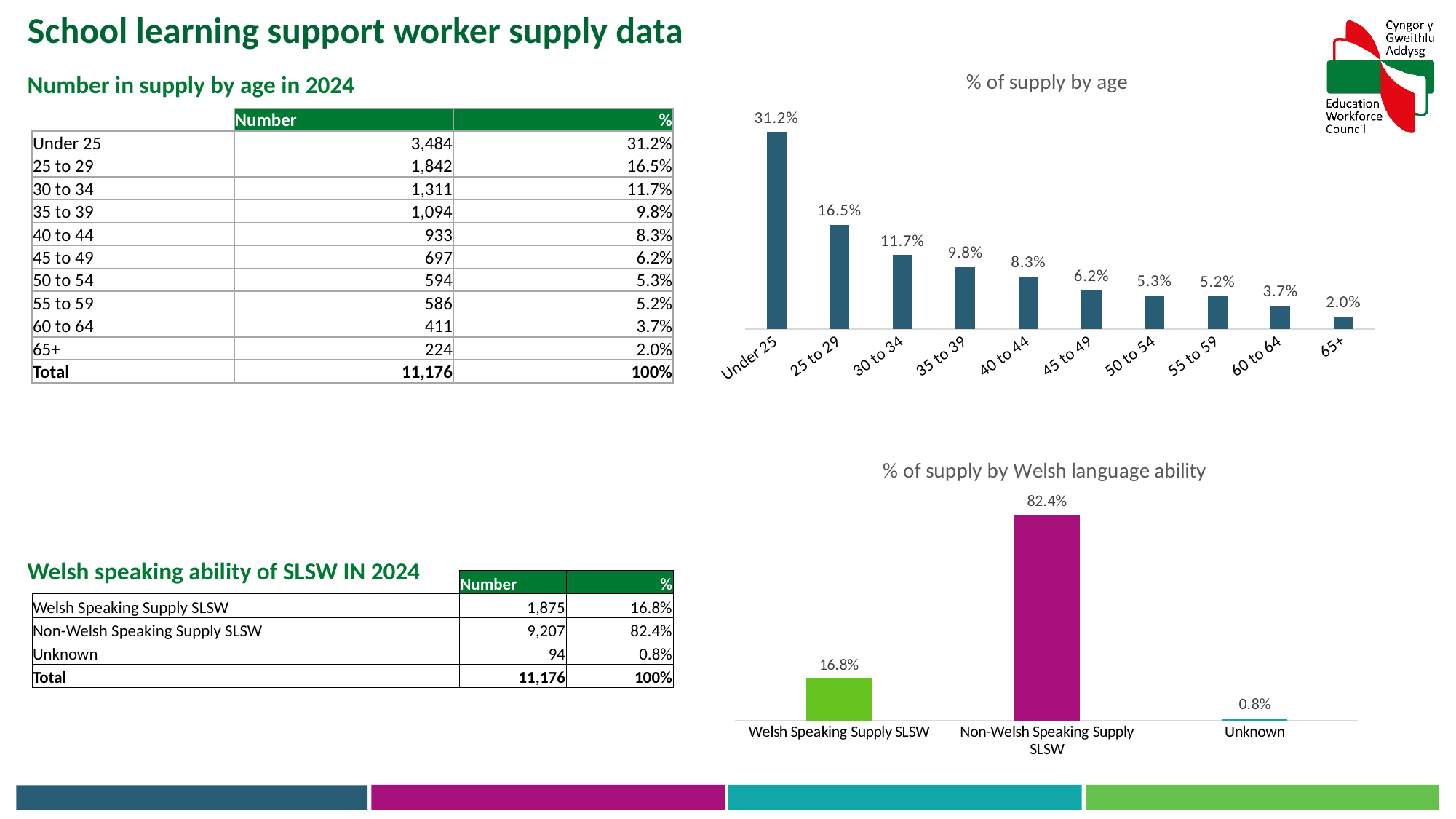
In the '% of supply by age' chart, what is the value for 30 to 34? 11.7% In the '% of supply by age' chart, which is larger, the value for 40 to 44 or the value for 45 to 49? 40 to 44 Do the values in the '% of supply by age' chart rise or fall from left to right along the x axis? fall In the '% of supply by age' chart, which age group has the highest value? Under 25 In the '% of supply by Welsh language ability' chart, what is the difference between the values for Non-Welsh Speaking Supply SLSW and Welsh Speaking Supply SLSW? 65.6% What kind of chart is the '% of supply by Welsh language ability' chart? bar chart In the '% of supply by Welsh language ability' chart, what is the value for Non-Welsh Speaking Supply SLSW? 82.4% How many age groups are shown in the '% of supply by age' chart? 10 In the '% of supply by age' chart, what is the value for 60 to 64? 3.7% In the '% of supply by Welsh language ability' chart, what colour is the bar for Welsh Speaking Supply SLSW? green In the '% of supply by age' chart, what is the difference between the values for Under 25 and 25 to 29? 14.7% In the '% of supply by age' chart, which age group has the lowest value? 65+